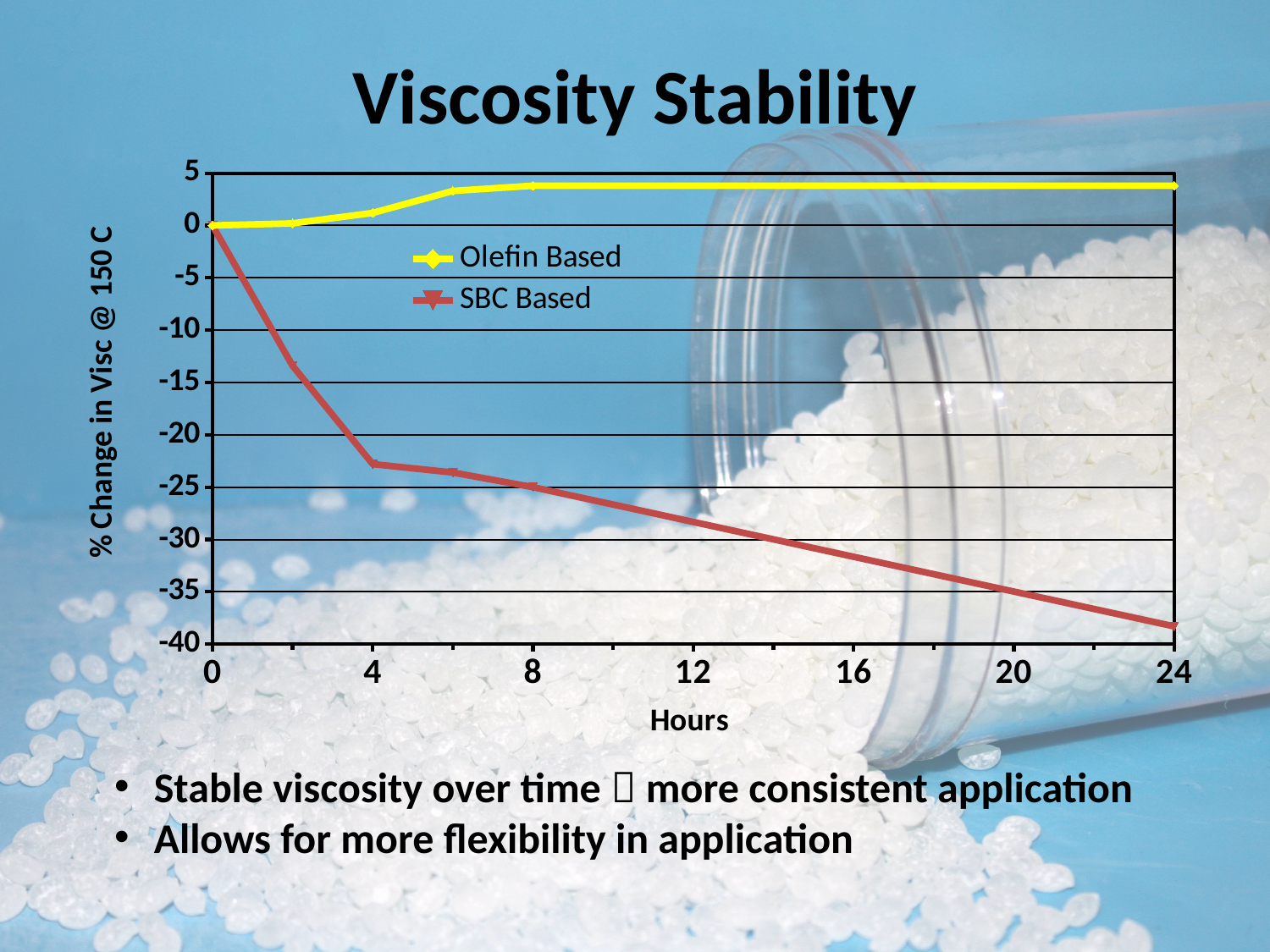
Which series has the higher value at 24 hours, Olefin Based or SBC Based? Olefin Based What is the label of the y axis? % Change in Visc @ 150 C Is the value for SBC Based at 4 hours greater or less than -20? less Does the SBC Based series rise or fall as hours increase? fall What is the title of the chart? Viscosity Stability What kind of chart is shown on the slide? line chart Is the value for SBC Based at 2 hours greater or less than -10? less Does the Olefin Based series rise or fall as hours increase? rise Which series has the lowest value on the chart? SBC Based How many series does the chart's legend list? 2 Is the value for Olefin Based at 24 hours greater or less than 0? greater